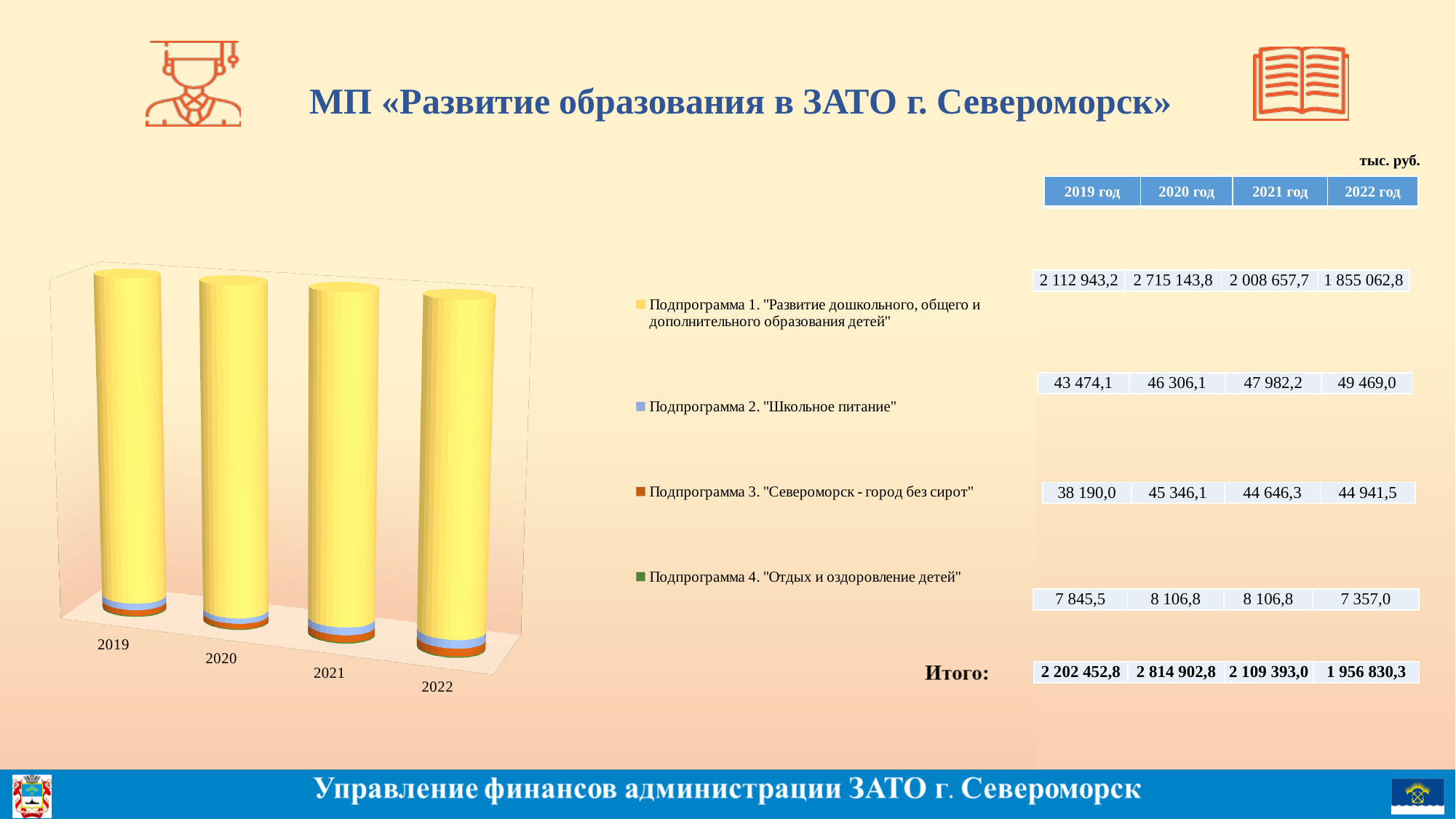
How many series does the chart legend list? 4 For Подпрограмма 3 "Североморск - город без сирот", which year has the larger value, 2020 or 2021? 2020 What is the total (Итого) of the stacked bar for 2020 год? 2 814 902,8 What is the difference between the 2019 and 2022 values for Подпрограмма 4 "Отдых и оздоровление детей"? 488,5 What kind of chart is shown on the slide? bar chart What is the value for Подпрограмма 1 "Развитие дошкольного, общего и дополнительного образования детей" in 2020 год? 2 715 143,8 What is the value for Подпрограмма 3 "Североморск - город без сирот" in 2019 год? 38 190,0 Do the values for Подпрограмма 2 "Школьное питание" rise or fall from 2019 to 2022? rise How many years (categories) are plotted along the x axis of the chart? 4 What is the value for Подпрограмма 2 "Школьное питание" in 2022 год? 49 469,0 Which year has the lowest total (Итого)? 2022 Which year has the highest total (Итого)? 2020